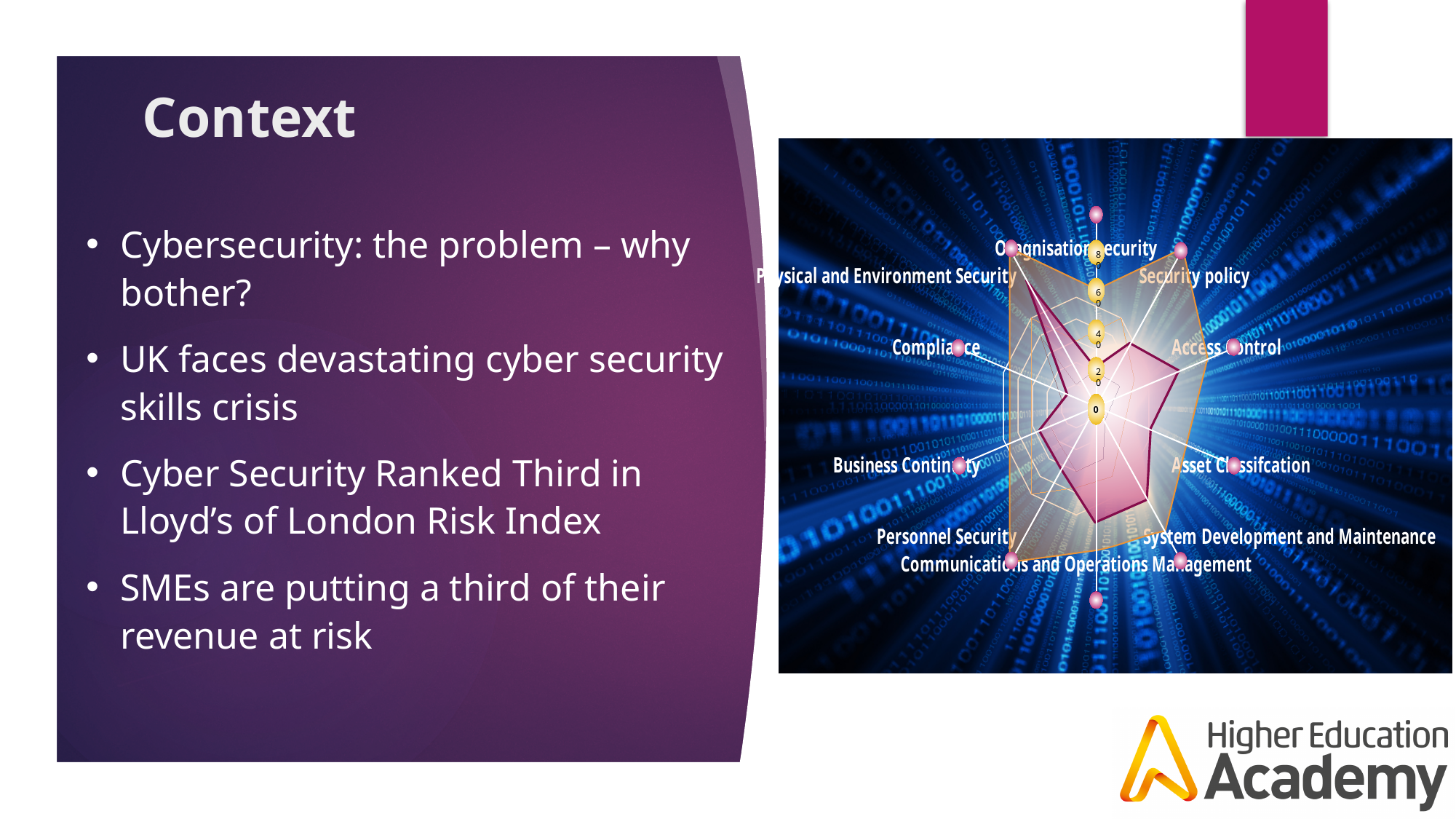
On the radar chart, which has the larger pink shaded series value: Access Control or Business Continuity? Access Control On the radar chart, is the pink shaded series' value for Access Control greater or less than 4? greater How many categories (axes) does the radar chart have? 10 On the radar chart, is the pink shaded series' value for Organisation Security greater or less than 4? less What kind of chart is shown on the right of the slide? Radar chart What is the highest tick value shown on the radar chart's axis? 80 What is the lowest tick value shown on the radar chart's axis? 0 On the radar chart, is the pink shaded series' value for Compliance greater or less than 4? less